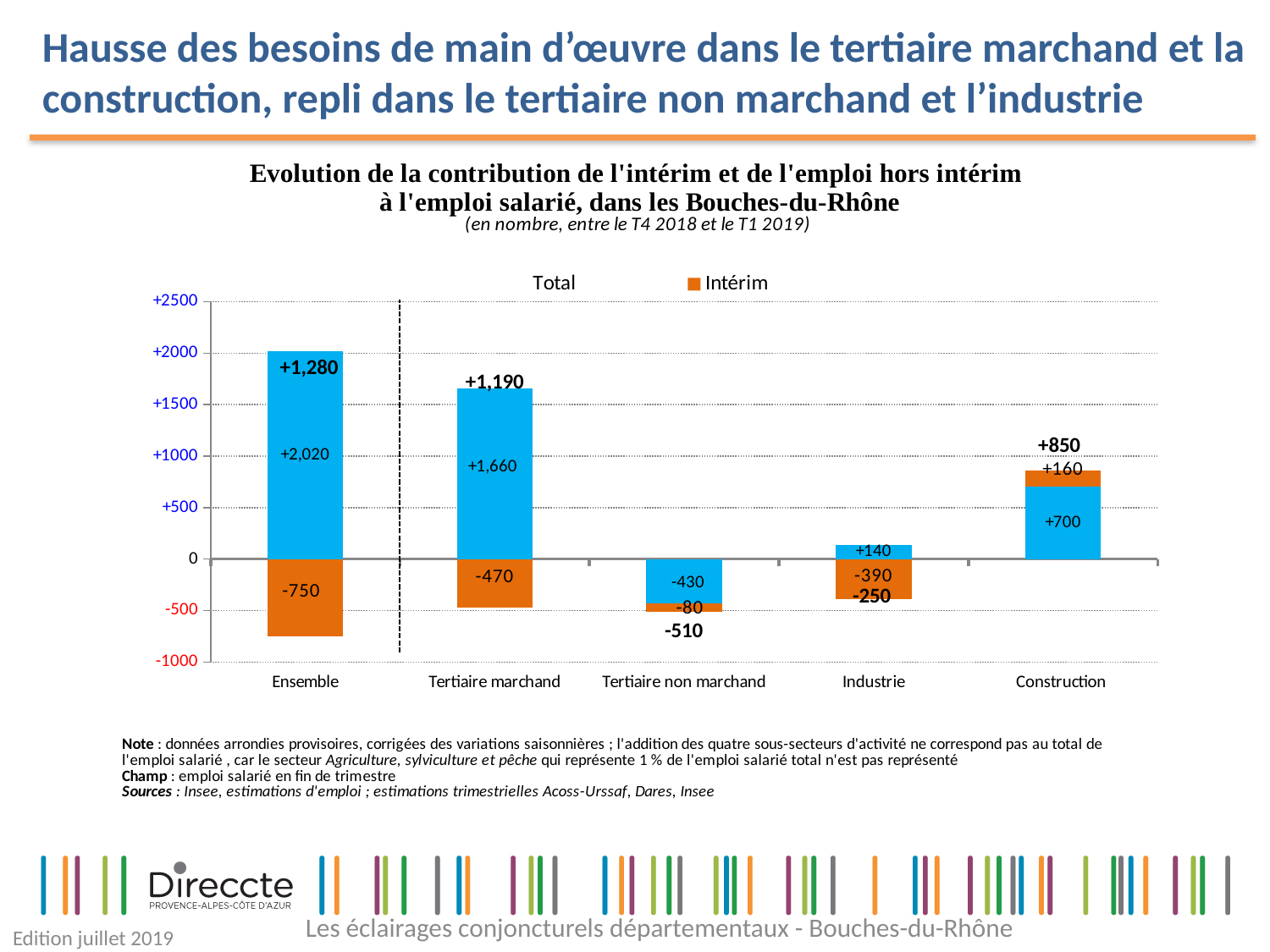
What is the Intérim value for Construction? +160 Which category has the highest total value? Ensemble What is the difference between the total for Ensemble (+1,280) and the total for Construction (+850)? 430 How many categories are shown on the x axis? 5 What is the Intérim value for Ensemble? -750 What kind of chart is this? Stacked bar chart Which category has the lowest total value? Tertiaire non marchand Which is larger, the Intérim value for Tertiaire marchand or the Intérim value for Industrie? Industrie What is the total value shown for Tertiaire marchand? +1,190 What is the total value shown for Tertiaire non marchand? -510 What is the Intérim value for Industrie? -390 What colour represents the Intérim series in the legend? Orange